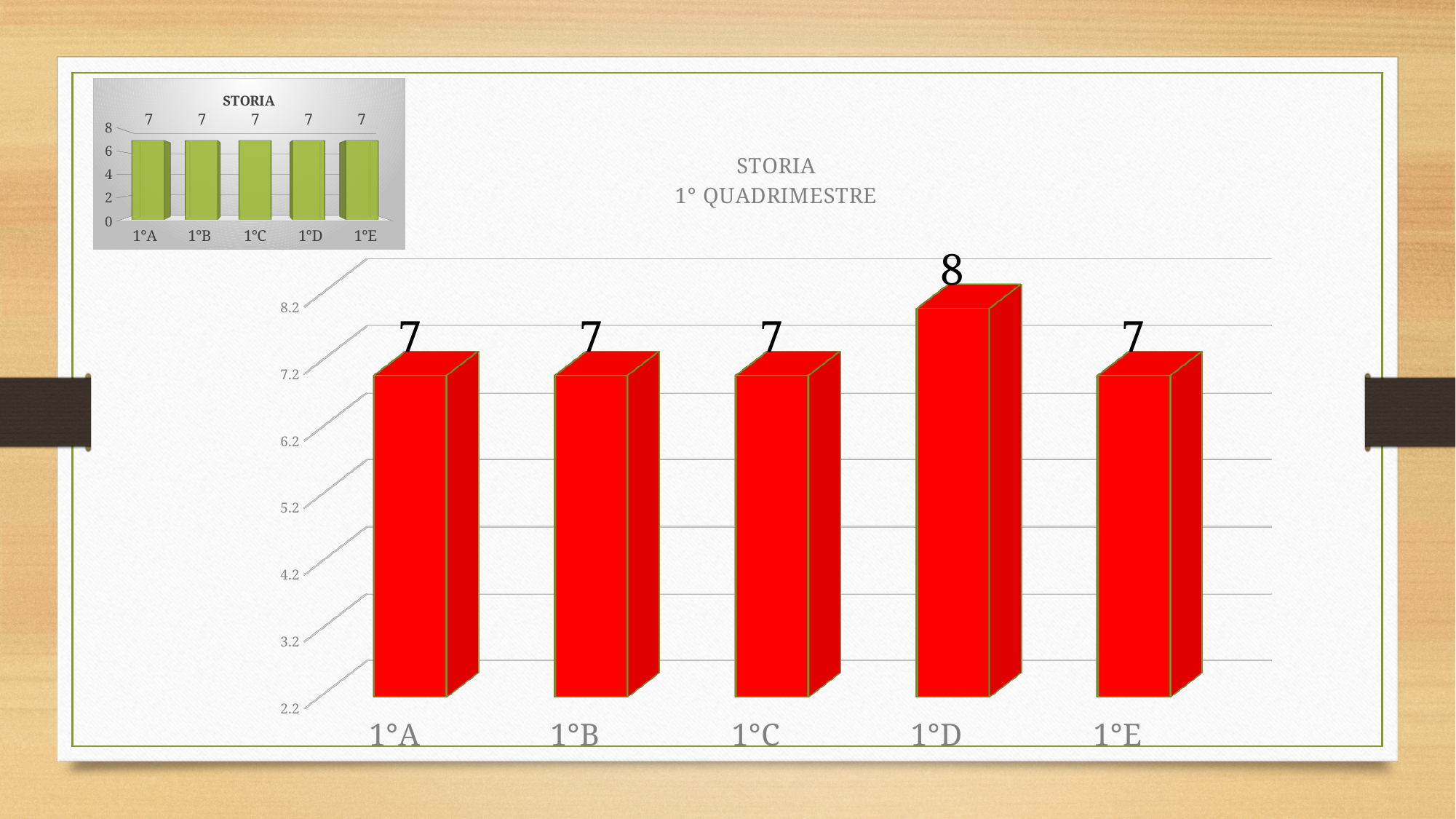
In the large chart titled 'STORIA 1° QUADRIMESTRE', what is the difference between the values for 1°D and 1°E? 1 In the small chart at the top left titled 'STORIA', how many bars are there? 5 In the small chart at the top left titled 'STORIA', what is the value for 1°C? 7 What kind of chart is the large chart titled 'STORIA 1° QUADRIMESTRE'? bar chart In the large chart titled 'STORIA 1° QUADRIMESTRE', what is the value for 1°A? 7 In the large chart titled 'STORIA 1° QUADRIMESTRE', which is larger, the value for 1°D or the value for 1°B? 1°D In the large chart titled 'STORIA 1° QUADRIMESTRE', what is the value for 1°D? 8 What colour are the bars in the large chart titled 'STORIA 1° QUADRIMESTRE'? red In the large chart titled 'STORIA 1° QUADRIMESTRE', which class has the highest value? 1°D What is the title of the large chart on the slide? STORIA 1° QUADRIMESTRE In the large chart titled 'STORIA 1° QUADRIMESTRE', how many classes are shown on the x axis? 5 In the small chart at the top left titled 'STORIA', is the value for 1°E greater or less than 4? greater